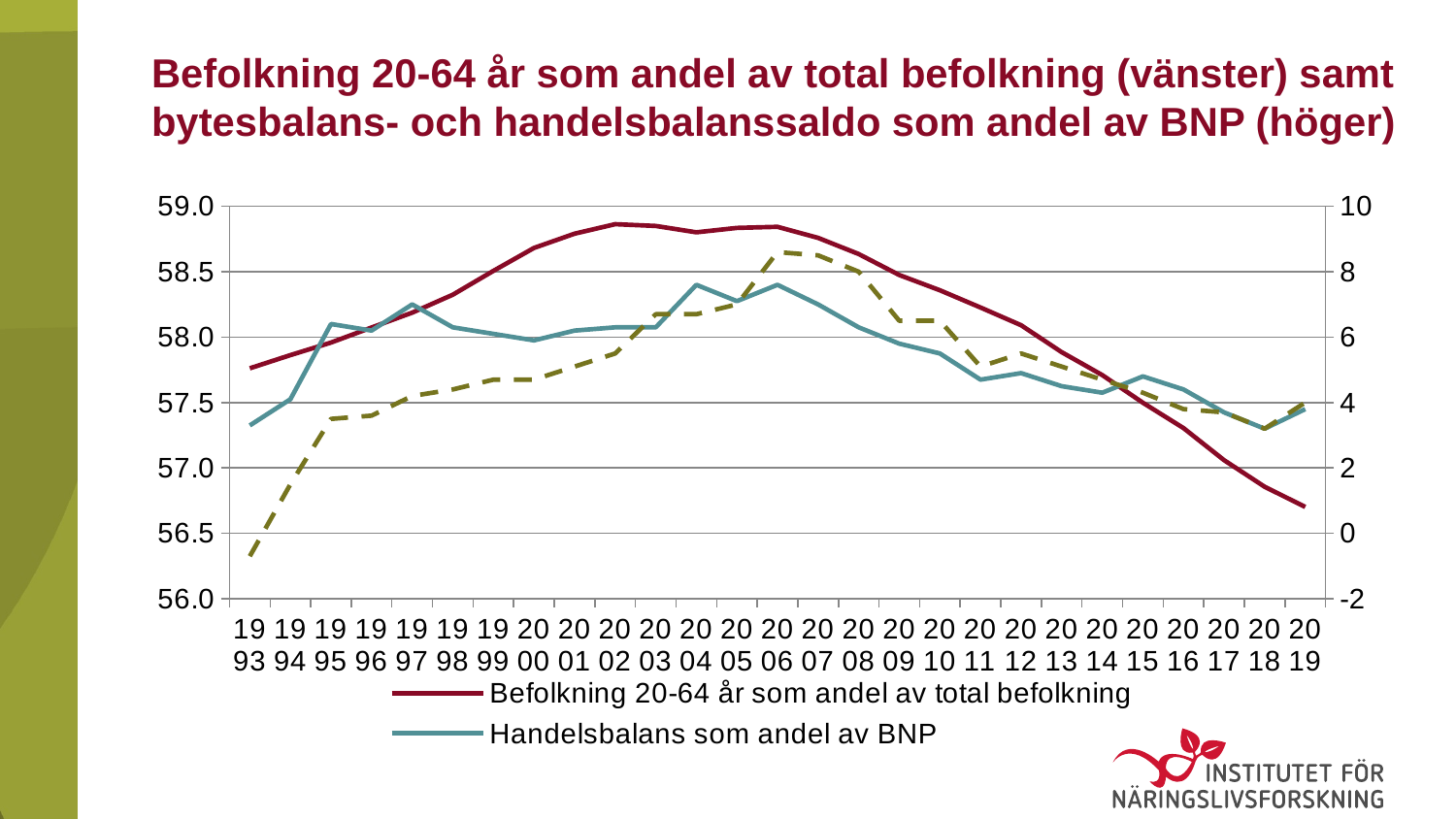
Does the 'Befolkning 20-64 år som andel av total befolkning' line rise or fall from 2006 to 2019? fall Is the value for 'Handelsbalans som andel av BNP' in 2004 greater or less than 6? greater In which year is the value for 'Befolkning 20-64 år som andel av total befolkning' lowest? 2019 What is the highest value shown on the right-hand axis? 10 How many years are plotted along the x axis? 27 What kind of chart is shown on the slide? line chart Does the 'Befolkning 20-64 år som andel av total befolkning' line rise or fall from 1993 to 2002? rise How many series does the legend list? 2 Is the value for 'Befolkning 20-64 år som andel av total befolkning' in 2002 greater or less than 58.5? greater Is the value for 'Befolkning 20-64 år som andel av total befolkning' in 1993 greater or less than 58.0? less Which is larger for 'Befolkning 20-64 år som andel av total befolkning': the value in 1993 or the value in 2019? 1993